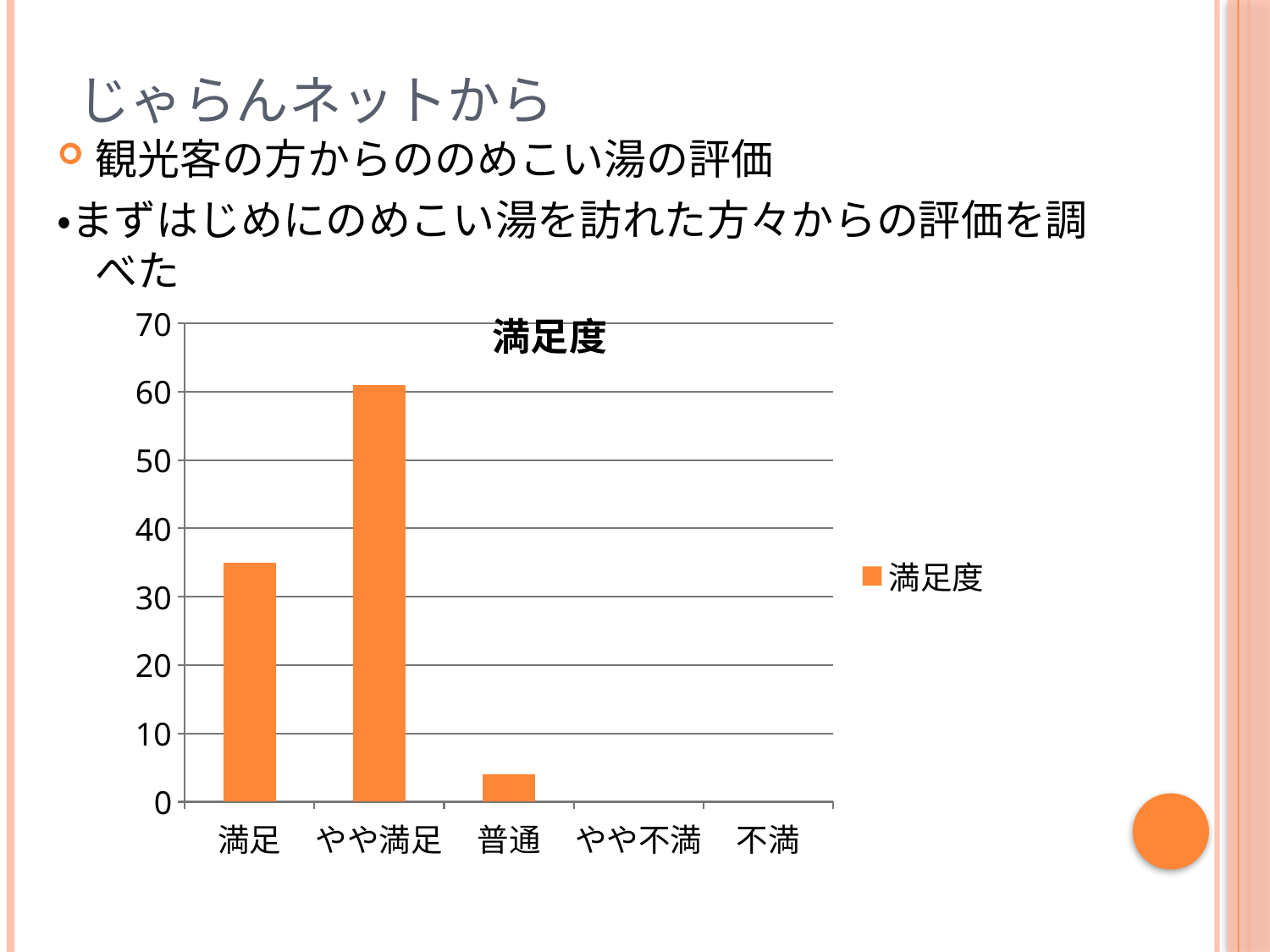
Which is larger, the value for 満足 or the value for やや満足? やや満足 Which category has the highest value in the chart? やや満足 Which is larger, the value for 満足 or the value for 普通? 満足 What kind of chart is shown on the slide? bar chart Is the value for 満足 greater or less than 30? greater How many series does the chart's legend list? 1 Is the value for やや満足 greater or less than 50? greater Is the value for 普通 greater or less than 10? less What is the legend entry shown for the chart? 満足度 What is the title of the chart? 満足度 How many categories are shown on the x axis of the chart? 5